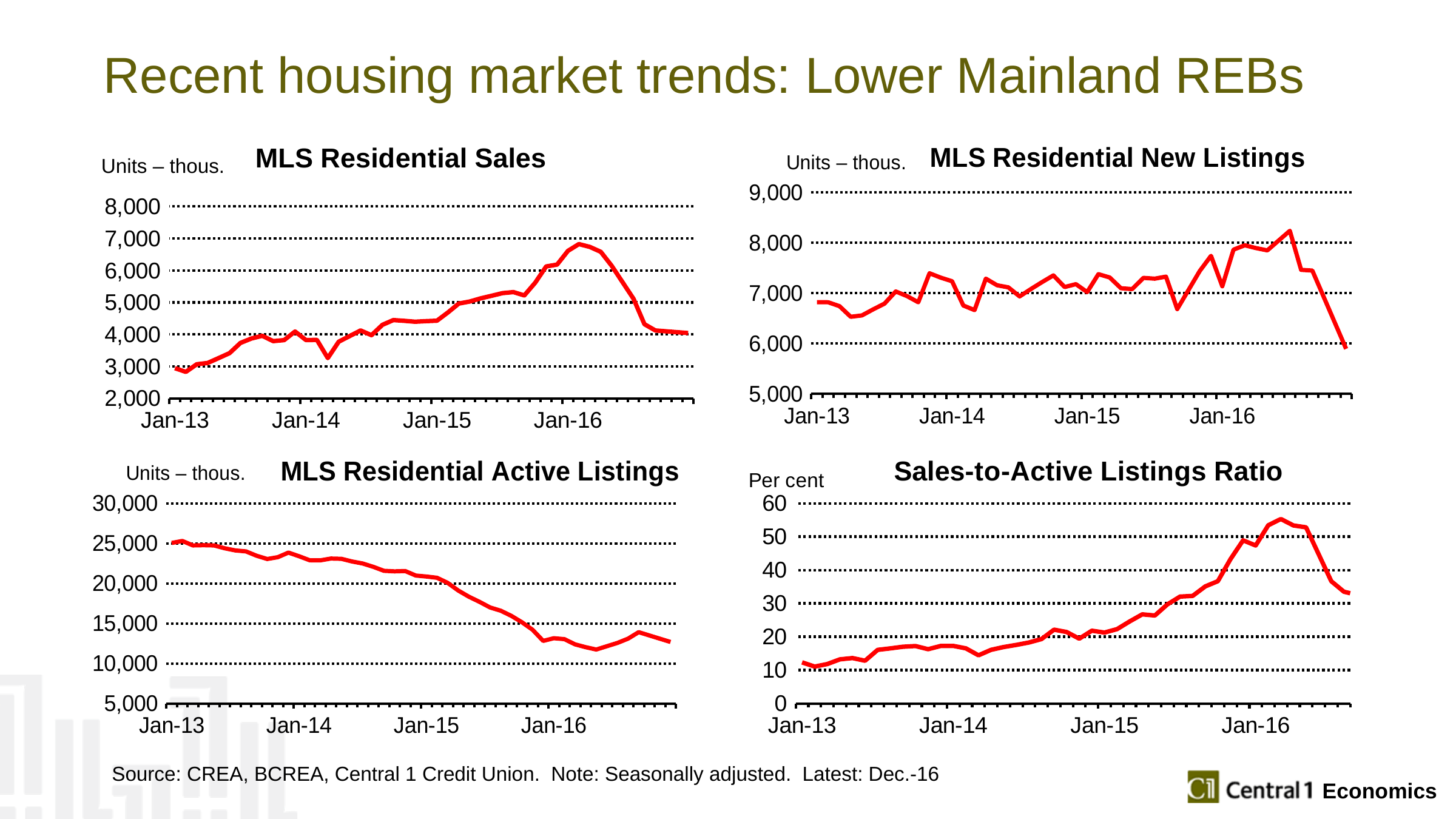
In the Sales-to-Active Listings Ratio chart, is the value at Jan-13 greater or less than 20? less In the MLS Residential Sales chart, is the peak value reached in early 2016 greater or less than 6,000? greater In the MLS Residential Active Listings chart, is the value at Jan-13 greater or less than 20,000? greater In the MLS Residential Active Listings chart, do the values rise or fall from Jan-13 to Jan-16? fall What unit label is shown above the y-axis of the MLS Residential Sales chart? Units – thous. What kind of chart is the MLS Residential Sales chart? line chart In the Sales-to-Active Listings Ratio chart, do the values rise or fall from Jan-13 to Jan-16? rise What unit label is shown above the y-axis of the Sales-to-Active Listings Ratio chart? Per cent